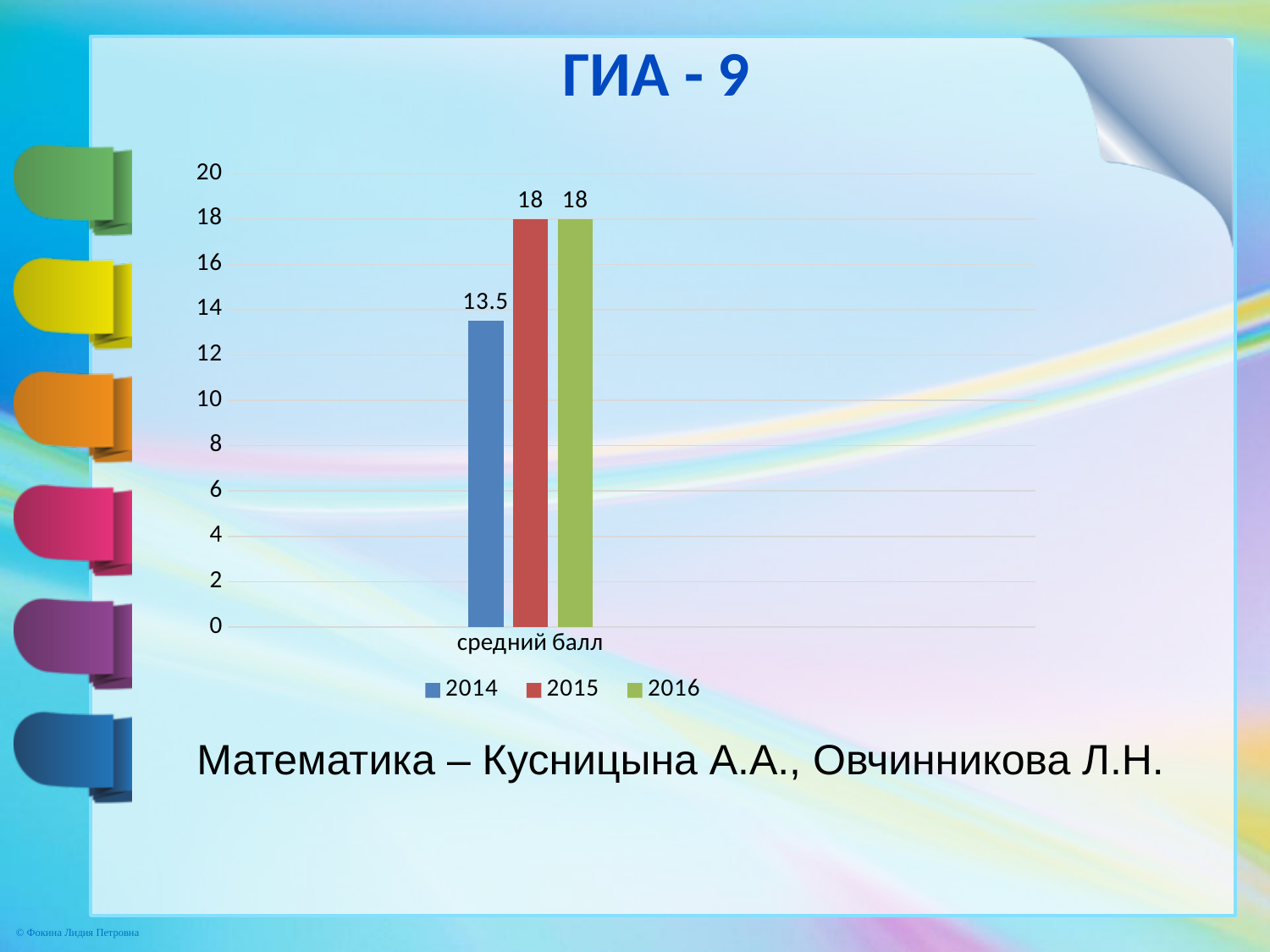
What is the difference between the 2015 value and the 2014 value? 4.5 What is the value for 2014 in the средний балл category? 13.5 What is the value for 2015 in the средний балл category? 18 Is the value for 2015 greater or less than 16? greater How many categories are shown on the x axis? 1 How many series does the legend list? 3 Which is larger, the value for 2014 or the value for 2016? 2016 What kind of chart is shown on the slide? bar chart Is the value for 2014 greater or less than 14? less What is the label of the category on the x axis? средний балл What is the value for 2016 in the средний балл category? 18 Which series has the lowest value for средний балл? 2014